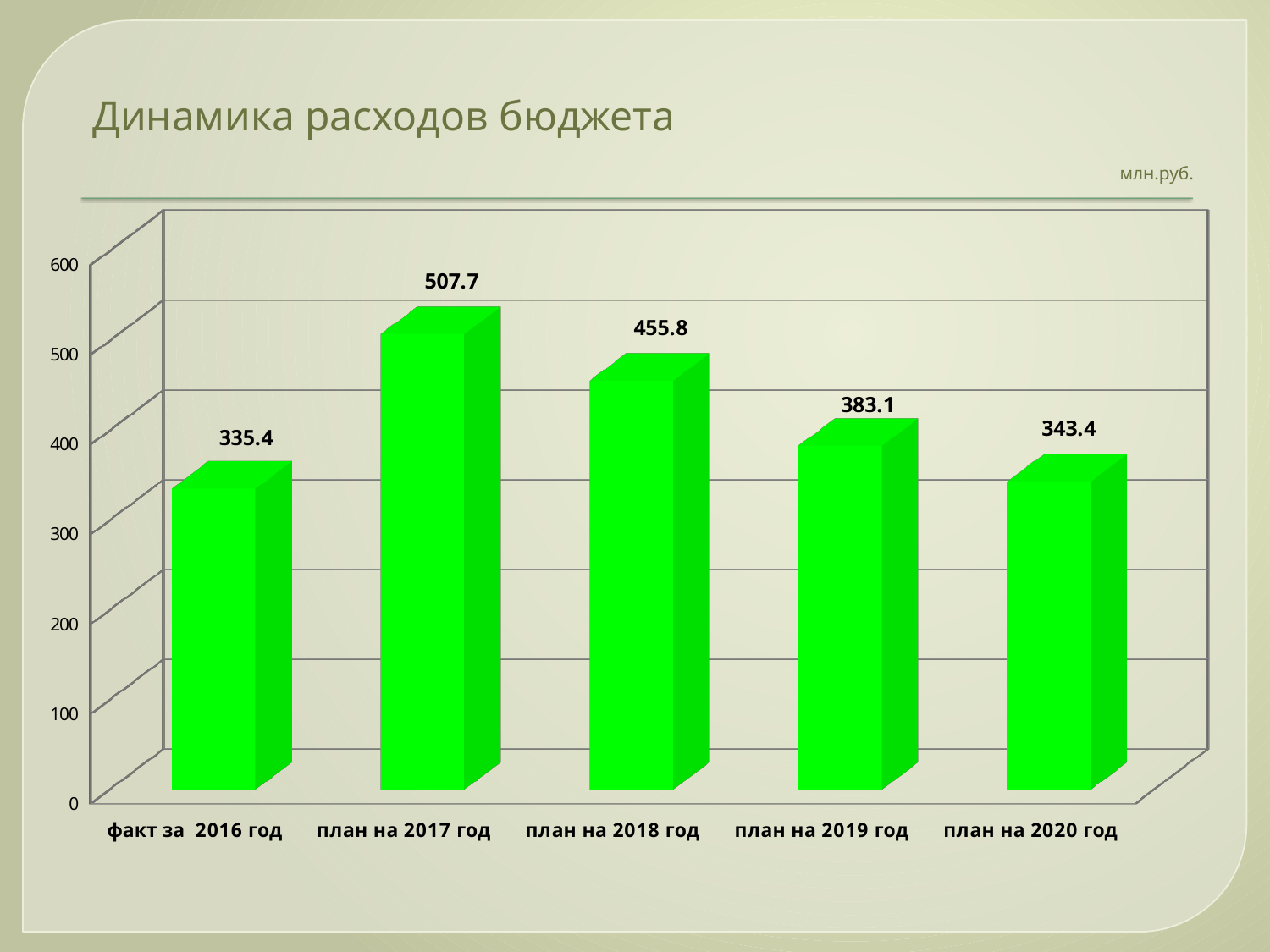
What is the value for план на 2020 год? 343.4 Which category has the highest value? план на 2017 год What is the title of the chart? Динамика расходов бюджета What is the value for план на 2017 год? 507.7 How many categories are shown on the chart? 5 What is the value for факт за 2016 год? 335.4 What is the difference between the values for план на 2017 год and план на 2018 год? 51.9 Is the value for план на 2019 год greater or less than 400? less Which category has the lowest value? факт за 2016 год What is the difference between the values for план на 2019 год and план на 2020 год? 39.7 What kind of chart is shown on the slide? bar chart Which is larger, the value for план на 2018 год or план на 2019 год? план на 2018 год